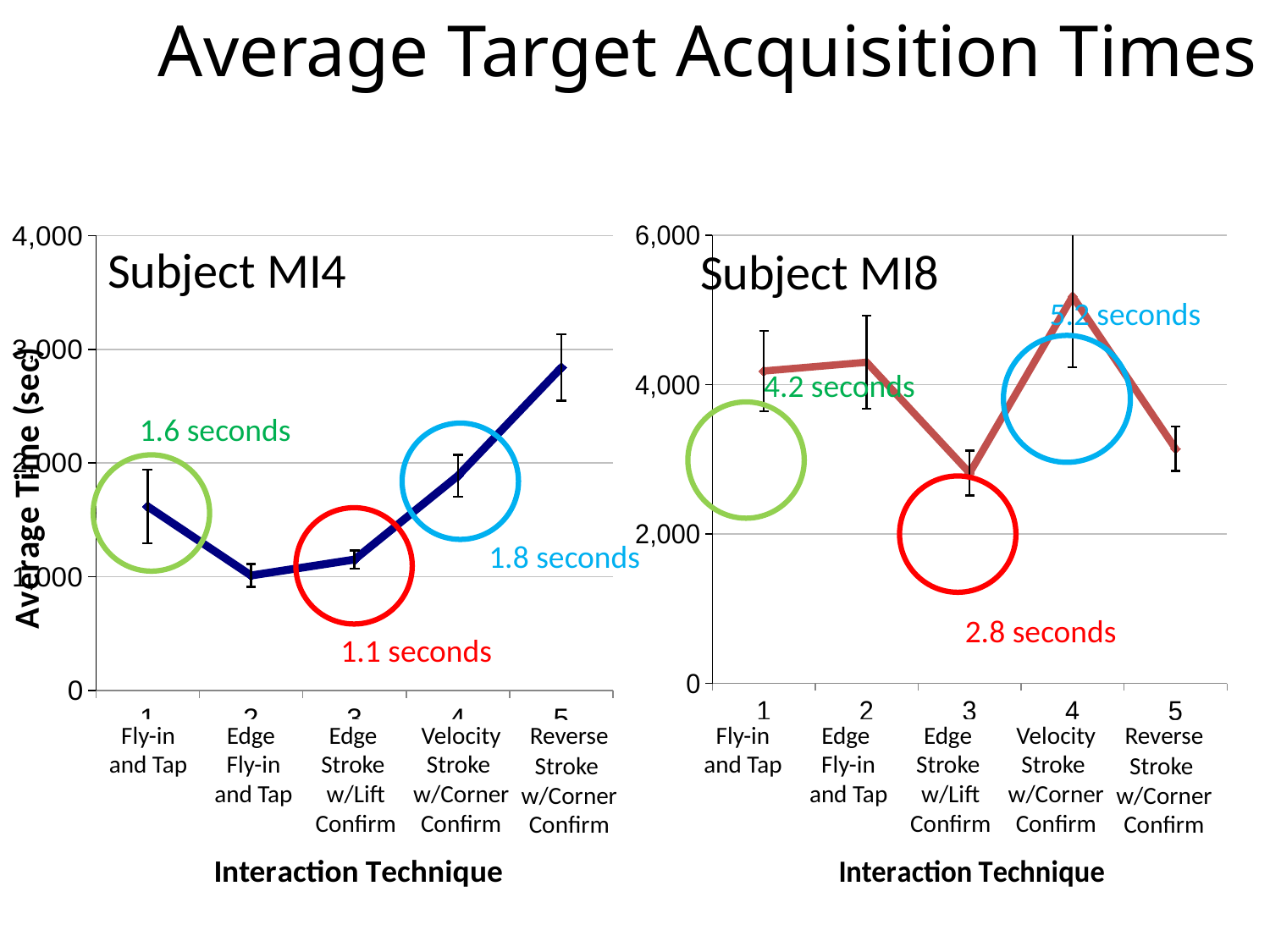
On the Subject MI8 chart, what is the annotated value for Velocity Stroke w/Corner Confirm? 5.2 seconds On the Subject MI4 chart, what is the annotated value for Fly-in and Tap? 1.6 seconds On the Subject MI4 chart, which interaction technique has the highest average time? Reverse Stroke w/Corner Confirm How many interaction techniques are plotted on the Subject MI4 chart? 5 On the Subject MI8 chart, what is the annotated value for Edge Stroke w/Lift Confirm? 2.8 seconds On the Subject MI8 chart, which interaction technique has the lowest average time? Edge Stroke w/Lift Confirm On the Subject MI4 chart, what is the annotated value for Edge Stroke w/Lift Confirm? 1.1 seconds What is the x-axis title on the Subject MI8 chart? Interaction Technique On the Subject MI8 chart, what is the difference between the annotated values for Velocity Stroke w/Corner Confirm and Edge Stroke w/Lift Confirm? 2.4 seconds On the Subject MI8 chart, is the value for Fly-in and Tap greater or less than 4,000? greater What kind of chart is the Subject MI8 chart? line chart On the Subject MI4 chart, which is larger: the value for Velocity Stroke w/Corner Confirm or the value for Edge Stroke w/Lift Confirm? Velocity Stroke w/Corner Confirm